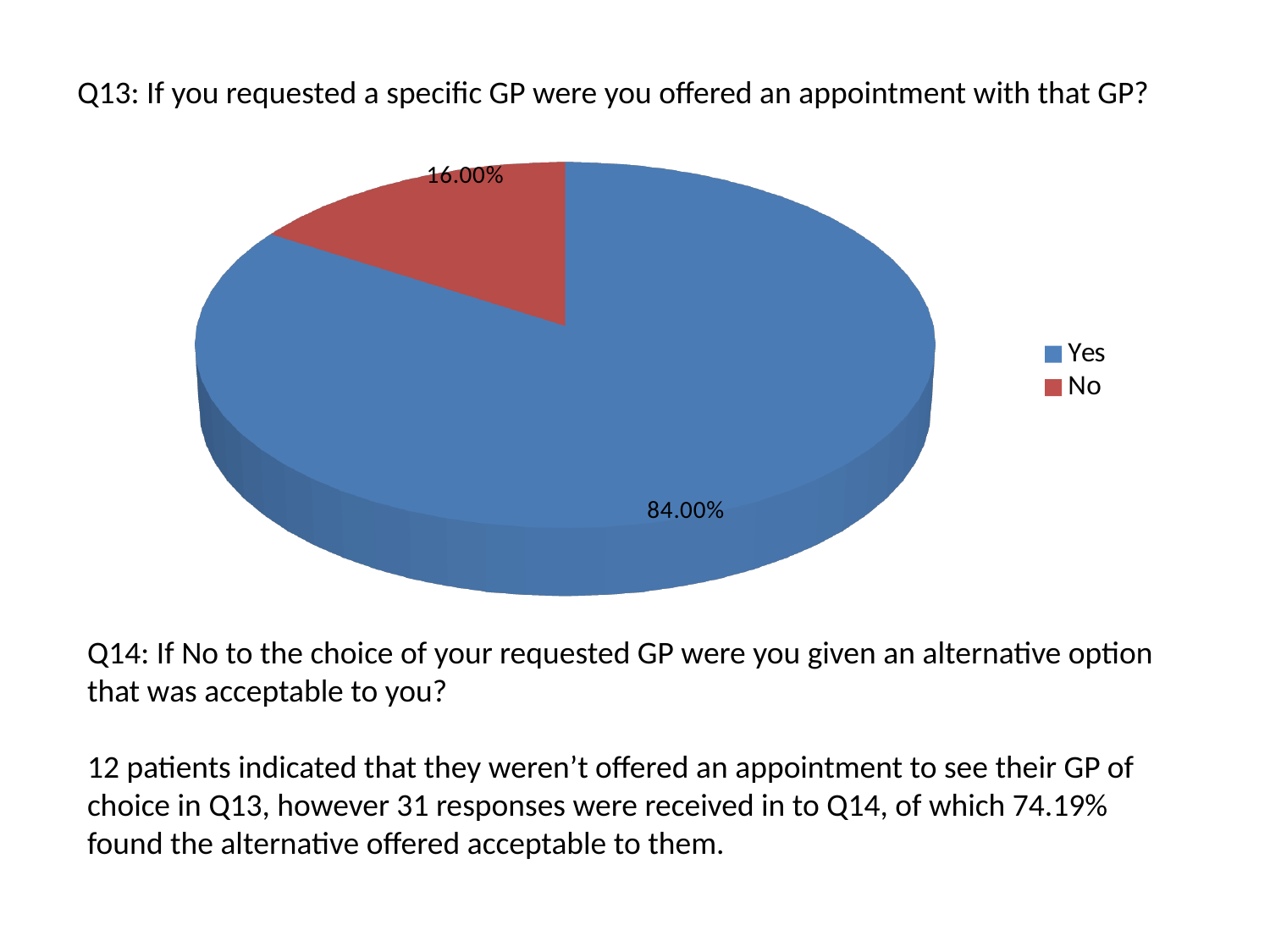
Which response has the smallest share of the pie? No What percentage of respondents answered No? 16.00% How many slices does the pie chart have? 2 What share of the pie does the No slice represent? 16.00% What colour is the No slice? red What kind of chart is shown on the slide? pie chart How many entries does the legend list? 2 Which response has the largest share of the pie? Yes Which is larger, the share for Yes or the share for No? Yes What percentage of respondents answered Yes? 84.00% What is the difference in percentage points between the Yes and No shares? 68.00% What colour is the Yes slice? blue